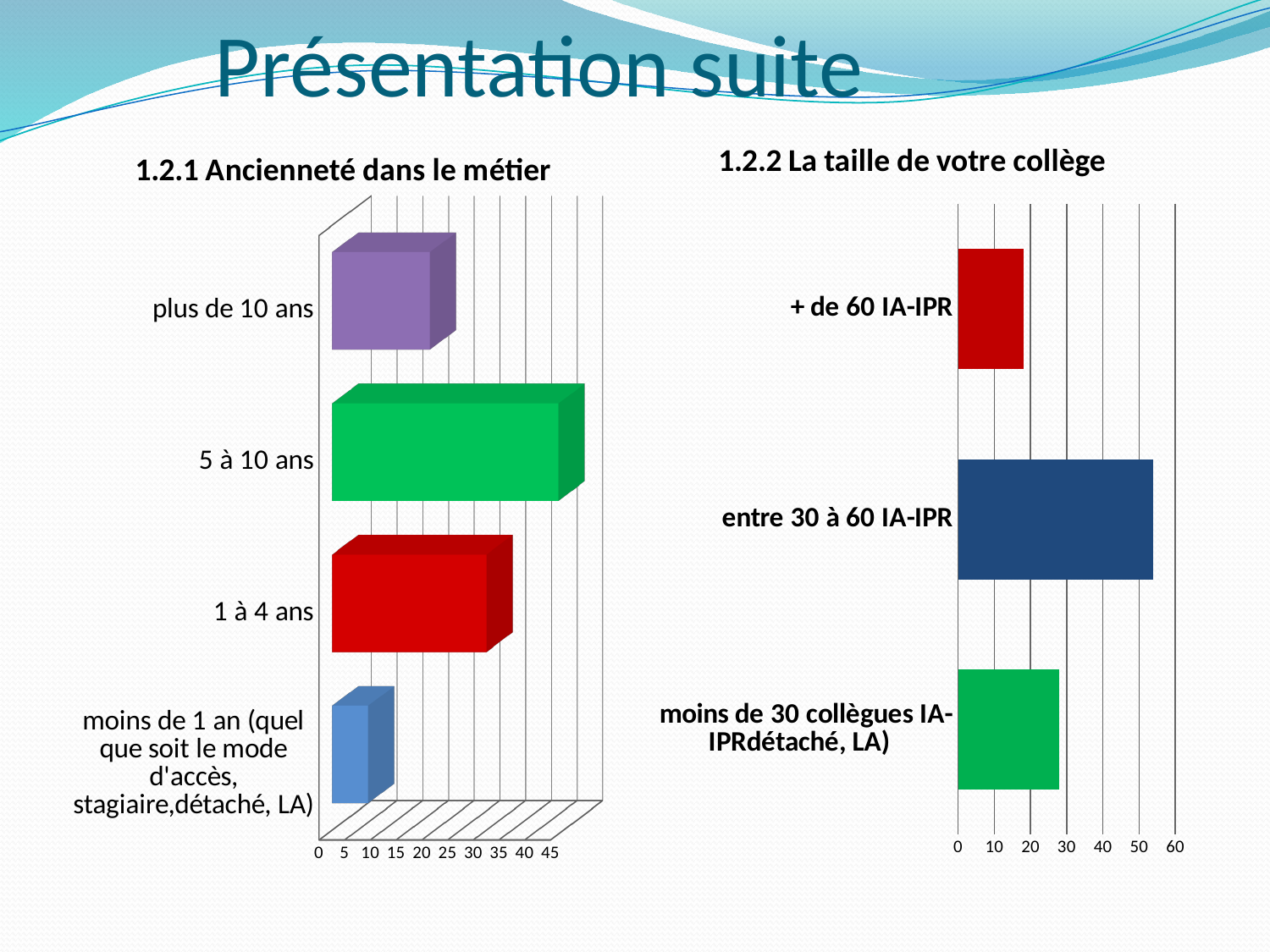
In the '1.2.1 Ancienneté dans le métier' chart, which category has the lowest value? moins de 1 an (quel que soit le mode d'accès, stagiaire,détaché, LA) In the '1.2.2 La taille de votre collège' chart, which category has the highest value? entre 30 à 60 IA-IPR In the '1.2.1 Ancienneté dans le métier' chart, which category has the highest value? 5 à 10 ans What kind of chart is the '1.2.2 La taille de votre collège' chart? bar chart How many categories does the '1.2.1 Ancienneté dans le métier' chart show? 4 How many categories does the '1.2.2 La taille de votre collège' chart show? 3 In the '1.2.2 La taille de votre collège' chart, which category has the lowest value? + de 60 IA-IPR In the '1.2.1 Ancienneté dans le métier' chart, is the value for '5 à 10 ans' greater or less than 35? greater In the '1.2.1 Ancienneté dans le métier' chart, is the value for 'plus de 10 ans' greater or less than 30? less In the '1.2.1 Ancienneté dans le métier' chart, which is larger: '1 à 4 ans' or 'plus de 10 ans'? 1 à 4 ans In the '1.2.2 La taille de votre collège' chart, is the value for 'entre 30 à 60 IA-IPR' greater or less than 40? greater What kind of chart is the '1.2.1 Ancienneté dans le métier' chart? bar chart